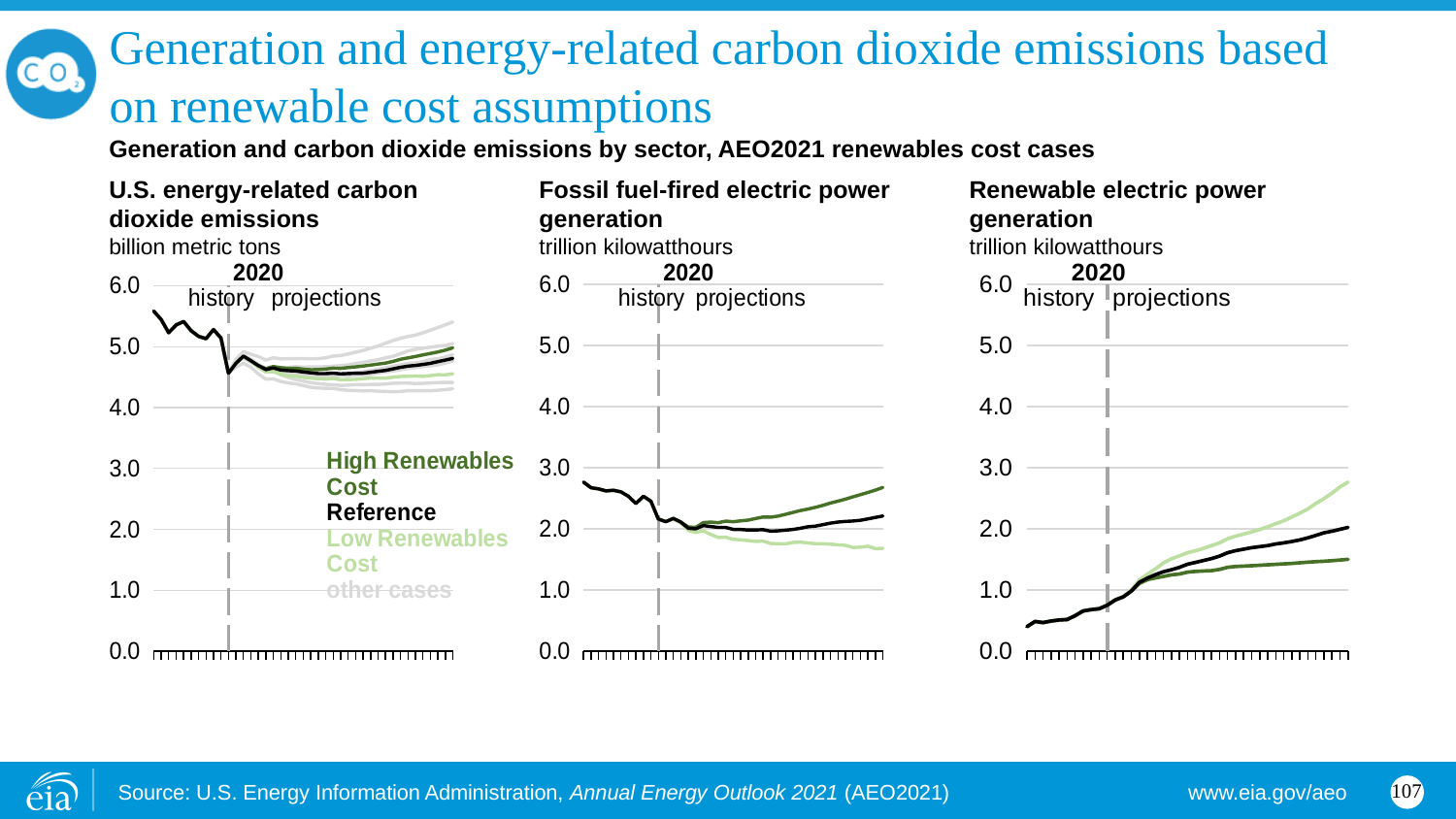
In the 'Renewable electric power generation' chart, is the value for the High Renewables Cost case at the end of the projection period greater or less than 2.0? less How many series does the legend on the 'U.S. energy-related carbon dioxide emissions' chart list? 4 What unit is used on the 'Fossil fuel-fired electric power generation' chart? trillion kilowatthours What year does the dashed vertical line separating history from projections mark on the charts? 2020 In the 'Renewable electric power generation' chart, is the value for the Low Renewables Cost case at the end of the projection period greater or less than 2.0? greater In the 'Renewable electric power generation' chart, which case is higher at the end of the projection period, Low Renewables Cost or High Renewables Cost? Low Renewables Cost In the 'Renewable electric power generation' chart, do the projected values rise or fall over time? rise In the 'Fossil fuel-fired electric power generation' chart, is the value for the High Renewables Cost case at the end of the projection period greater or less than 2.0? greater What kind of chart is the 'U.S. energy-related carbon dioxide emissions' chart? line chart In the 'Fossil fuel-fired electric power generation' chart, which case is higher at the end of the projection period, High Renewables Cost or Low Renewables Cost? High Renewables Cost